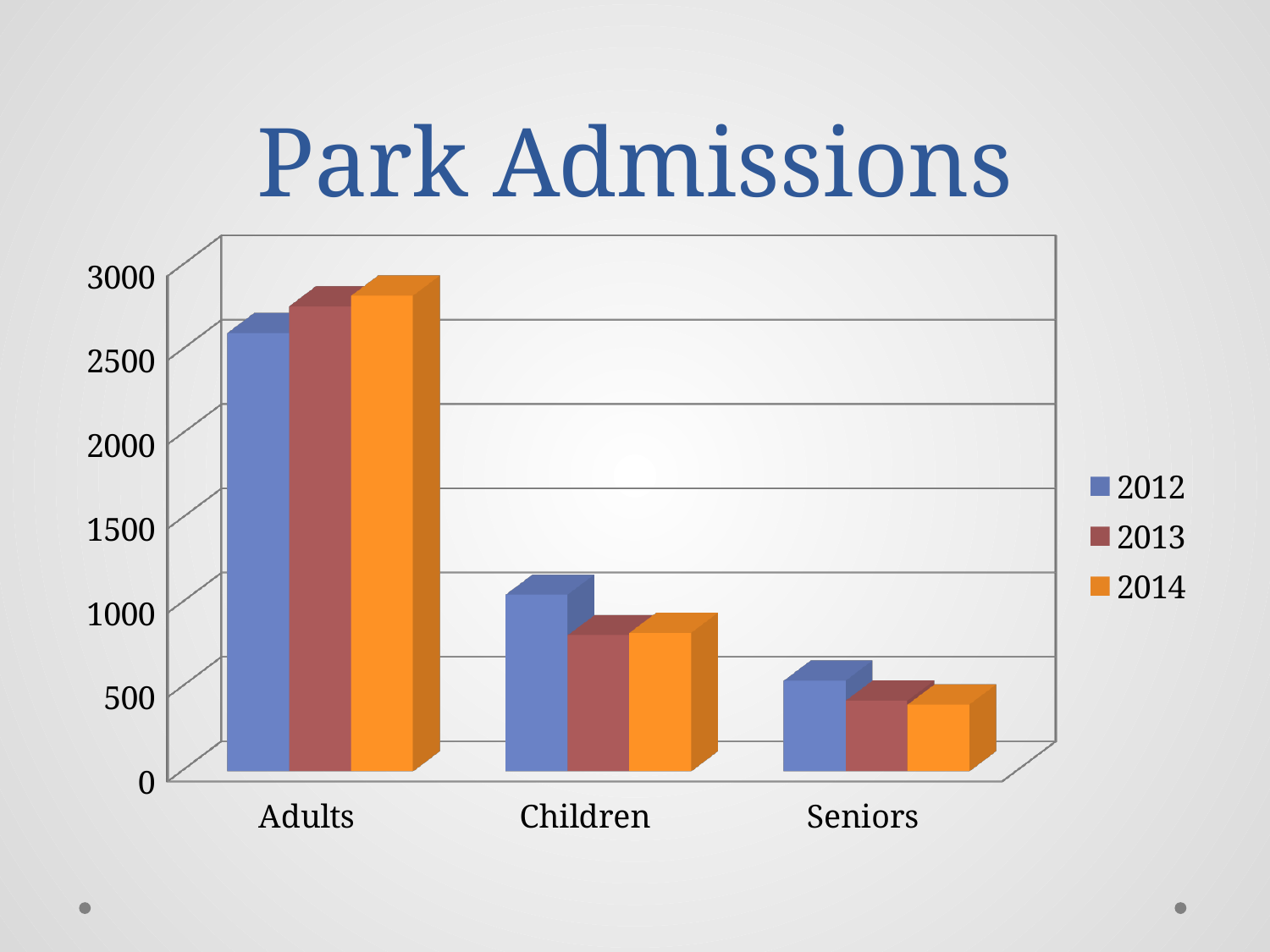
Is the value for Adults in 2014 greater or less than 3000? less Do the 2013 values rise or fall moving from Adults to Seniors along the x axis? fall Which category has the lowest admissions in 2012? Seniors What kind of chart is shown on the slide? bar chart Is the value for Seniors in 2014 greater or less than 500? less For Children, which year has the larger value, 2012 or 2013? 2012 How many series does the legend list? 3 What is the title of the chart? Park Admissions For Adults, which year has the larger value, 2012 or 2014? 2014 Is the value for Children in 2013 greater or less than 1000? less Which category has the highest admissions in 2014? Adults How many categories are shown on the x axis? 3